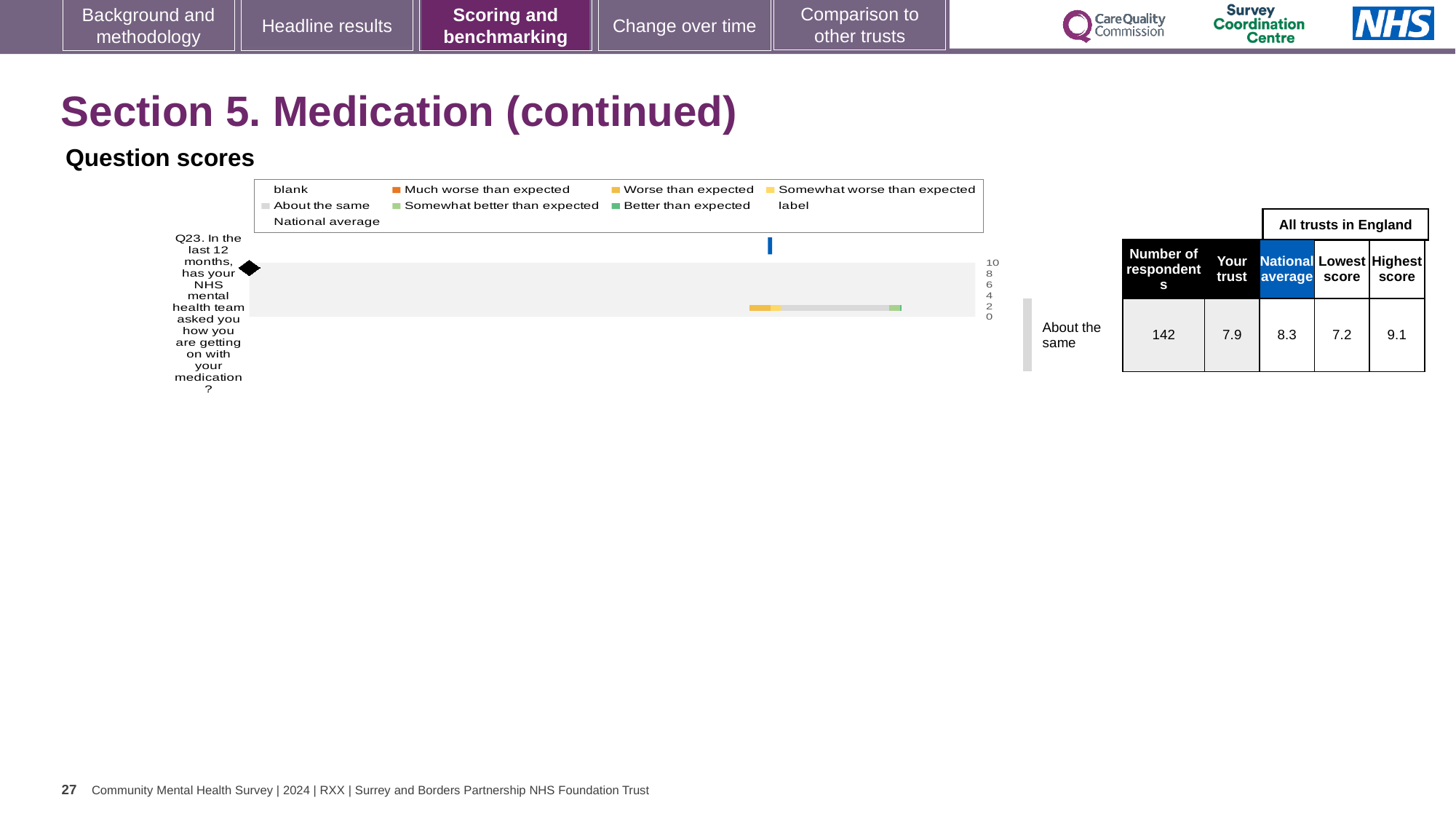
What is the national average score for Q23 in the table beside the chart? 8.3 What benchmark category is shown for Q23 next to the chart? About the same How many respondents answered Q23? 142 How many survey questions are plotted in the Question scores chart? 1 What kind of chart is shown under 'Question scores'? bar chart What is the 'Your trust' score for Q23 in the table beside the chart? 7.9 Which question is plotted in the Question scores chart? Q23. In the last 12 months, has your NHS mental health team asked you how you are getting on with your medication? What is the highest score among all trusts in England for Q23? 9.1 What is the lowest score among all trusts in England for Q23? 7.2 What is the difference between the highest score and the lowest score for Q23? 1.9 For Q23, which is larger: the 'Your trust' score or the national average? National average What is the difference between the national average and the 'Your trust' score for Q23? 0.4